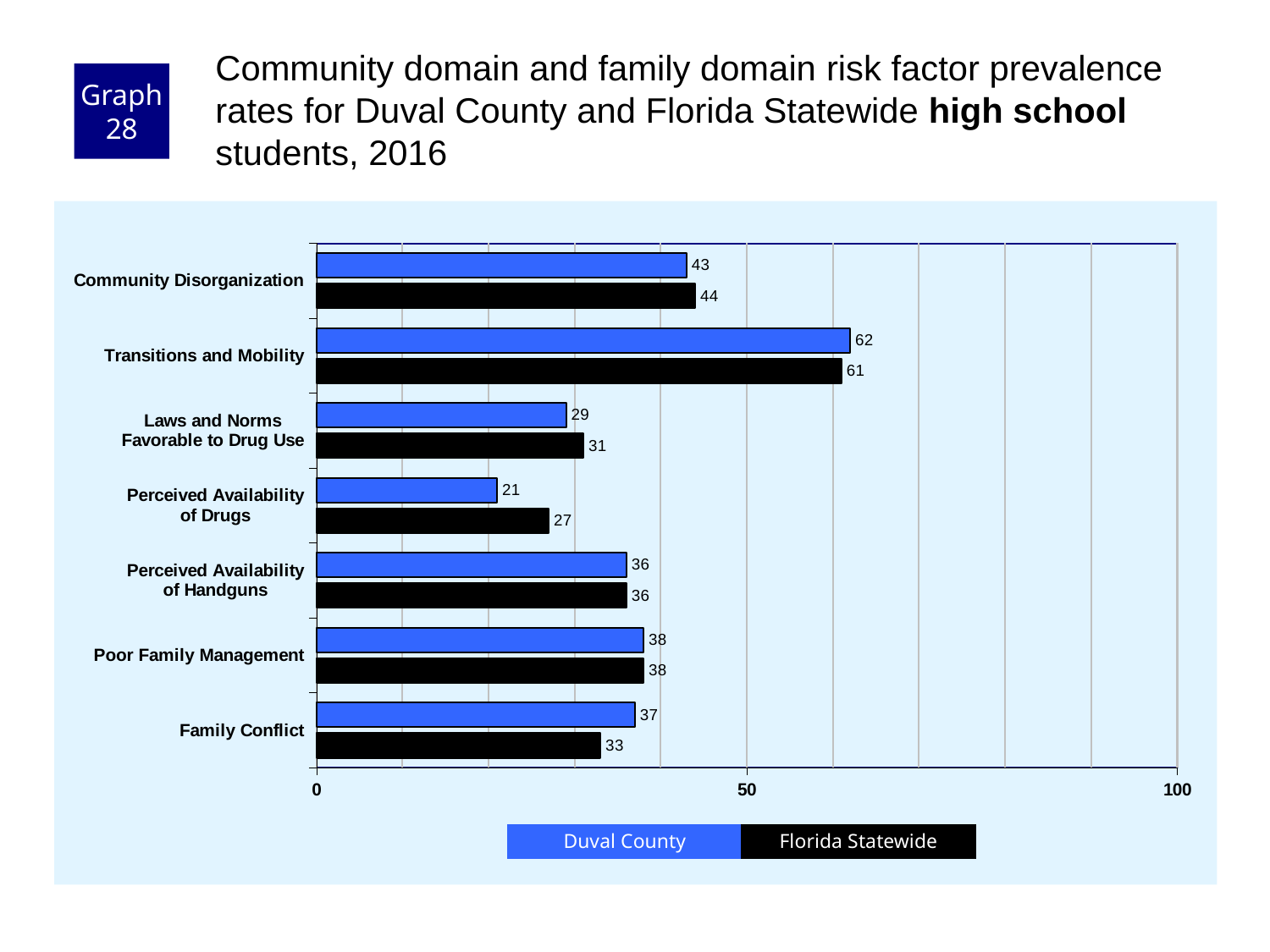
How many series does the legend list? 2 Which risk factor has the highest Duval County value? Transitions and Mobility Which risk factor has the lowest Duval County value? Perceived Availability of Drugs Is the Duval County value for Transitions and Mobility greater or less than 50? greater What is the Florida Statewide value for Family Conflict? 33 Which colour represents Florida Statewide in the chart? Black What kind of chart is shown on the slide? Bar chart What is the Duval County value for Transitions and Mobility? 62 What is the Florida Statewide value for Perceived Availability of Drugs? 27 For Family Conflict, which is larger: the Duval County value or the Florida Statewide value? Duval County What is the difference between the Florida Statewide and Duval County values for Perceived Availability of Drugs? 6 How many risk factor categories are shown on the chart? 7